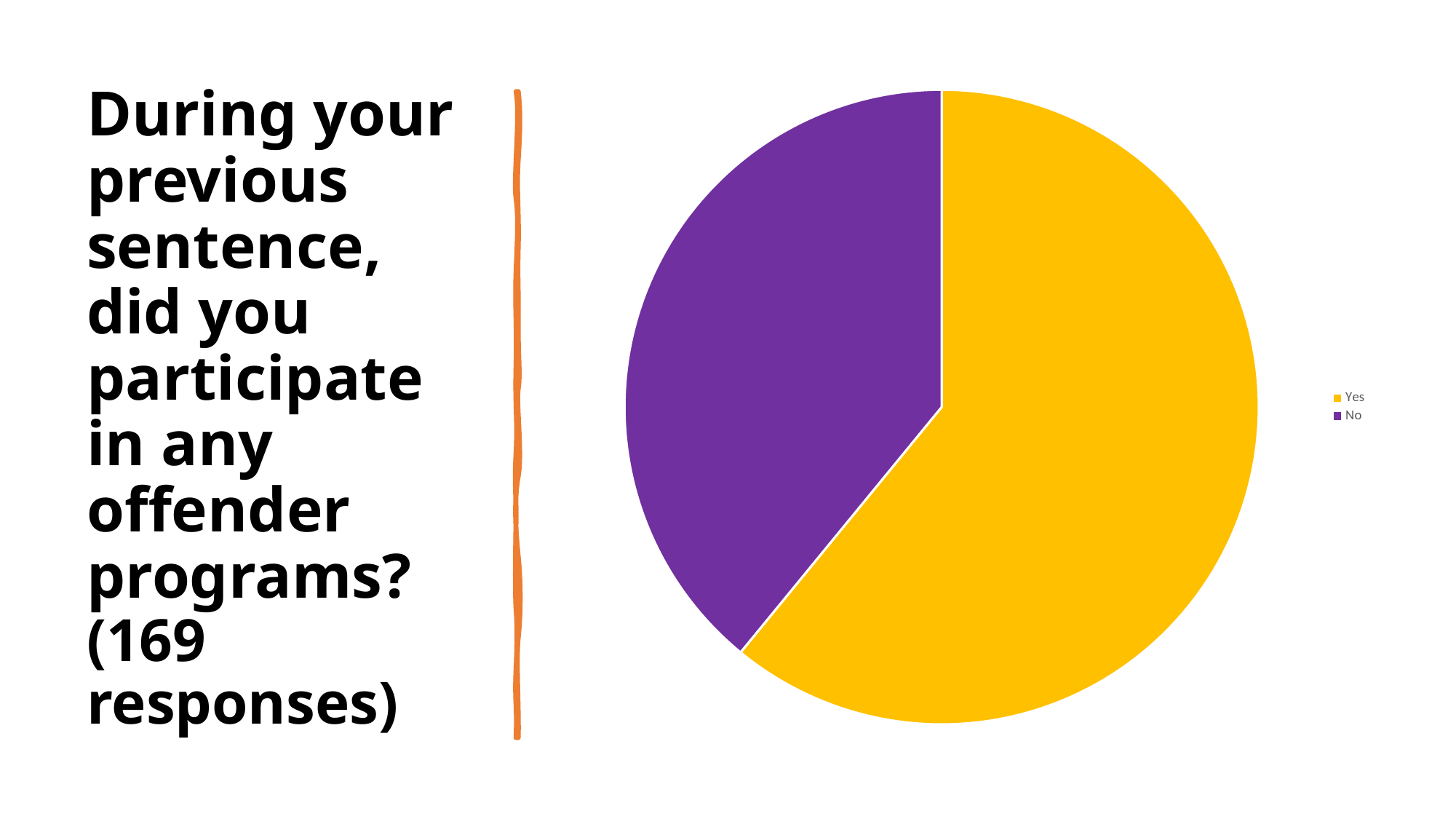
Which response has the largest slice of the pie chart? Yes What colour is the Yes slice in the pie chart? yellow How many entries does the legend of the pie chart list? 2 Which slice is larger in the pie chart, Yes or No? Yes How many slices does the pie chart have? 2 What kind of chart is shown on the slide? pie chart Which response has the smallest slice of the pie chart? No How many responses does the slide say the chart is based on? 169